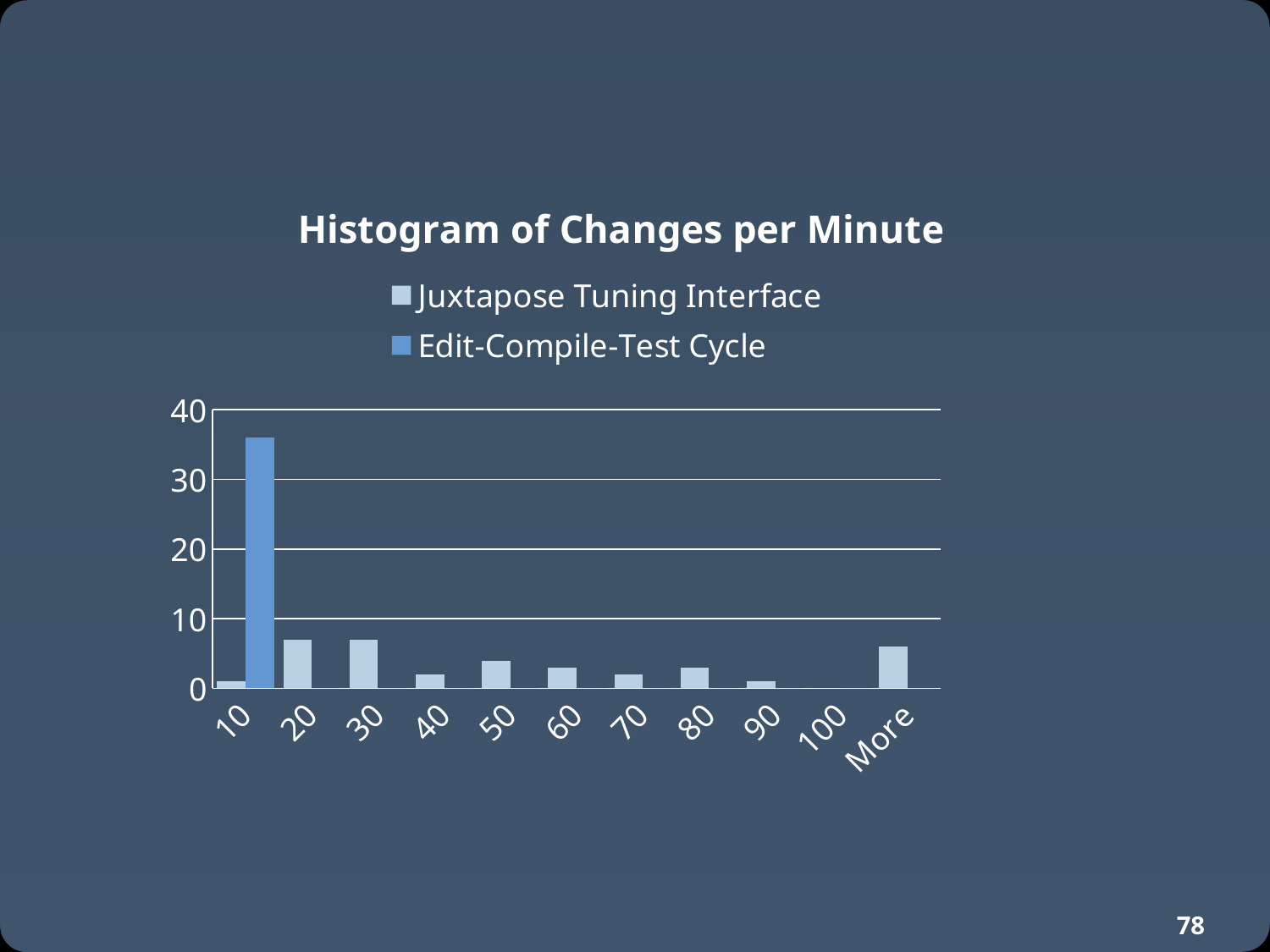
Which two series are listed in the legend? Juxtapose Tuning Interface and Edit-Compile-Test Cycle How many series does the legend list? 2 Which category has the tallest bar in the chart? 10 What is the title of the chart? Histogram of Changes per Minute Is the Juxtapose Tuning Interface value for the More category greater or less than 10? less For the Juxtapose Tuning Interface series, which is larger: the value for 50 or the value for 40? 50 Is the Edit-Compile-Test Cycle value for the 10 category greater or less than 30? greater How many categories are shown on the x axis? 11 Is the Juxtapose Tuning Interface value for the 20 category greater or less than 10? less For the Juxtapose Tuning Interface series, which is larger: the value for 20 or the value for 90? 20 What kind of chart is shown on the slide? bar chart For the 10 category, which series has the larger value: Juxtapose Tuning Interface or Edit-Compile-Test Cycle? Edit-Compile-Test Cycle